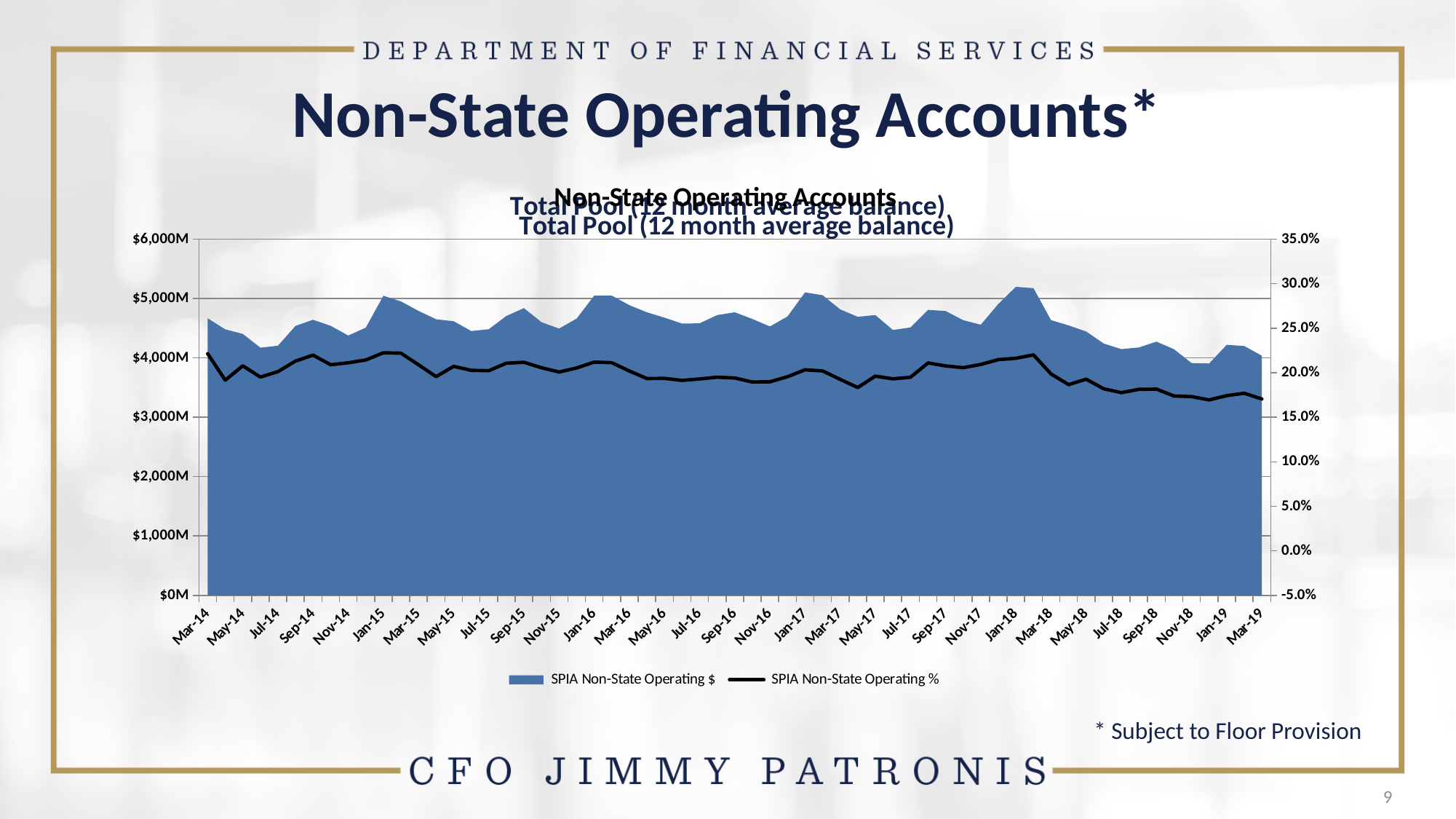
Is the SPIA Non-State Operating % value for Mar-19 greater or less than 20.0%? less Is the SPIA Non-State Operating % value for Mar-14 greater or less than 20.0%? greater Is the SPIA Non-State Operating % value for Jul-18 greater or less than 20.0%? less How many series does the chart legend list? 2 Which month shows the highest value for SPIA Non-State Operating $? Jan-18 What are the two entries in the chart legend? SPIA Non-State Operating $ and SPIA Non-State Operating % What colour is the shaded area representing SPIA Non-State Operating $? Blue Does the SPIA Non-State Operating % line overall rise or fall from Mar-14 to Mar-19? fall Which is larger, the SPIA Non-State Operating $ value for Jan-18 or for Mar-19? Jan-18 What kind of chart is shown on the slide? Area chart with a line series